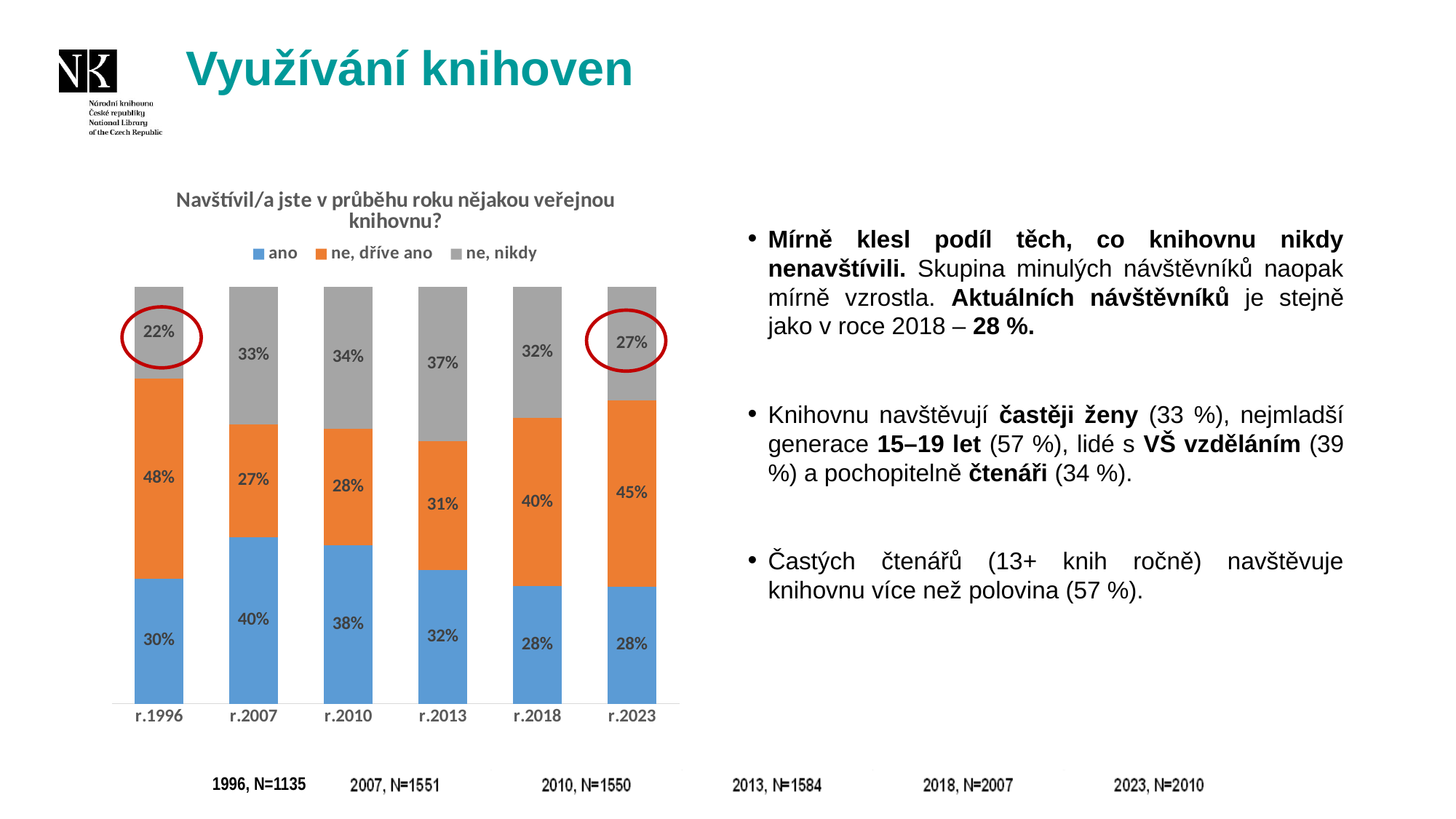
In which year is the 'ano' share the highest? r.2007 What is the total of the three segments in the r.1996 bar? 100% What is the value of 'ne, dříve ano' for r.2023? 45% Which is larger: the 'ne, nikdy' value for r.2010 or for r.2023? r.2010 In which year is the 'ne, nikdy' share the lowest? r.1996 How many series does the chart legend list? 3 How many year categories are shown on the x axis of the chart? 6 Which series is shown in orange in the chart? ne, dříve ano What is the difference between the 'ne, dříve ano' value for r.2023 and for r.2018? 5% What type of chart is shown on the slide? stacked bar chart What is the value of 'ano' for r.2007? 40% What is the value of 'ne, nikdy' for r.2013? 37%